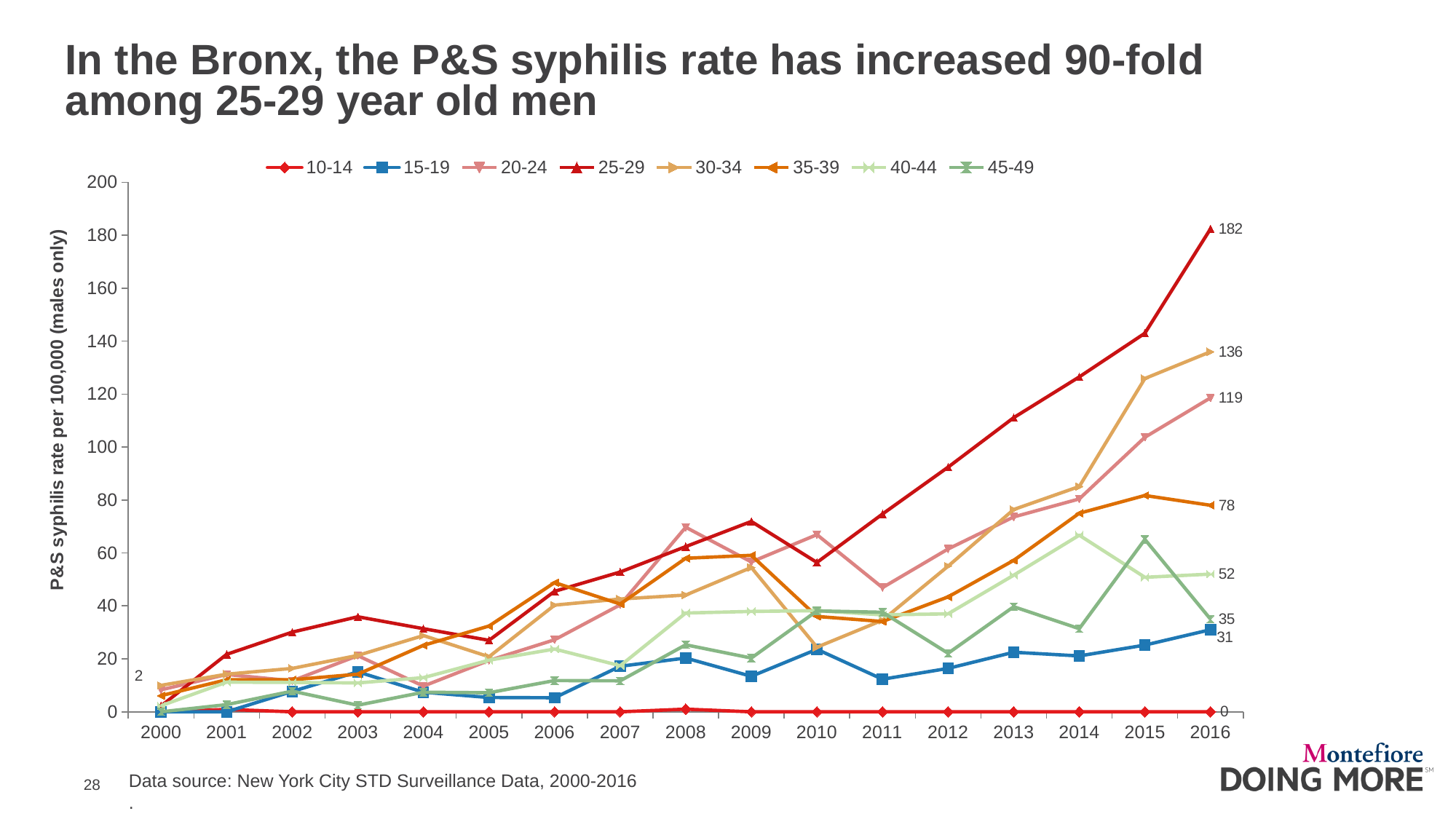
What is the P&S syphilis rate for the 30-34 age group in 2016? 136 In 2016, which age group has a higher rate: 40-44 or 45-49? 40-44 What type of chart is shown on the slide? line chart Which age group has the lowest P&S syphilis rate in 2016? 10-14 What is the P&S syphilis rate for the 15-19 age group in 2016? 31 Is the value for the 25-29 age group in 2014 greater or less than 120? greater Which age group has the highest P&S syphilis rate in 2016? 25-29 What is the P&S syphilis rate for the 20-24 age group in 2016? 119 What is the P&S syphilis rate for the 25-29 age group in 2016? 182 What is the P&S syphilis rate for the 35-39 age group in 2016? 78 What is the difference between the 2016 rates for the 25-29 and 30-34 age groups? 46 How many series does the legend list? 8